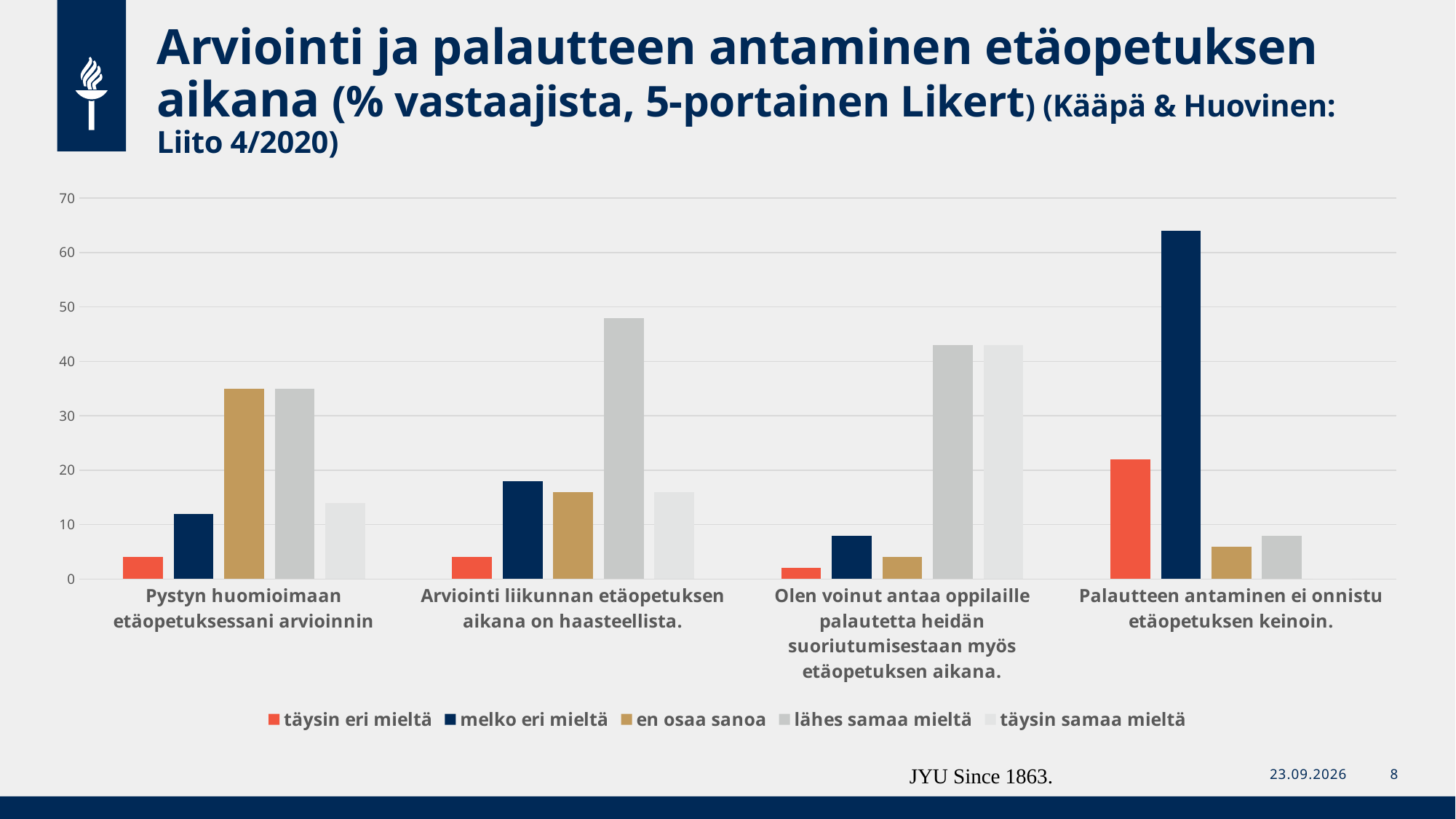
How many series does the legend list? 5 Is the 'en osaa sanoa' value for 'Pystyn huomioimaan etäopetuksessani arvioinnin' greater or less than 30? greater For 'Olen voinut antaa oppilaille palautetta heidän suoriutumisestaan myös etäopetuksen aikana.', which series has the lowest bar? täysin eri mieltä Which is larger: the 'lähes samaa mieltä' value for 'Arviointi liikunnan etäopetuksen aikana on haasteellista.' or for 'Olen voinut antaa oppilaille palautetta heidän suoriutumisestaan myös etäopetuksen aikana.'? Arviointi liikunnan etäopetuksen aikana on haasteellista. Is the 'täysin eri mieltä' value for 'Palautteen antaminen ei onnistu etäopetuksen keinoin.' greater or less than 20? greater For which statement is the 'melko eri mieltä' bar the highest? Palautteen antaminen ei onnistu etäopetuksen keinoin. Is the 'melko eri mieltä' value for 'Palautteen antaminen ei onnistu etäopetuksen keinoin.' greater or less than 60? greater Which series is shown in red/orange in the legend? täysin eri mieltä How many statement categories are shown along the x axis? 4 What kind of chart is shown on the slide? bar chart For 'Pystyn huomioimaan etäopetuksessani arvioinnin', which is larger: 'täysin eri mieltä' or 'melko eri mieltä'? melko eri mieltä